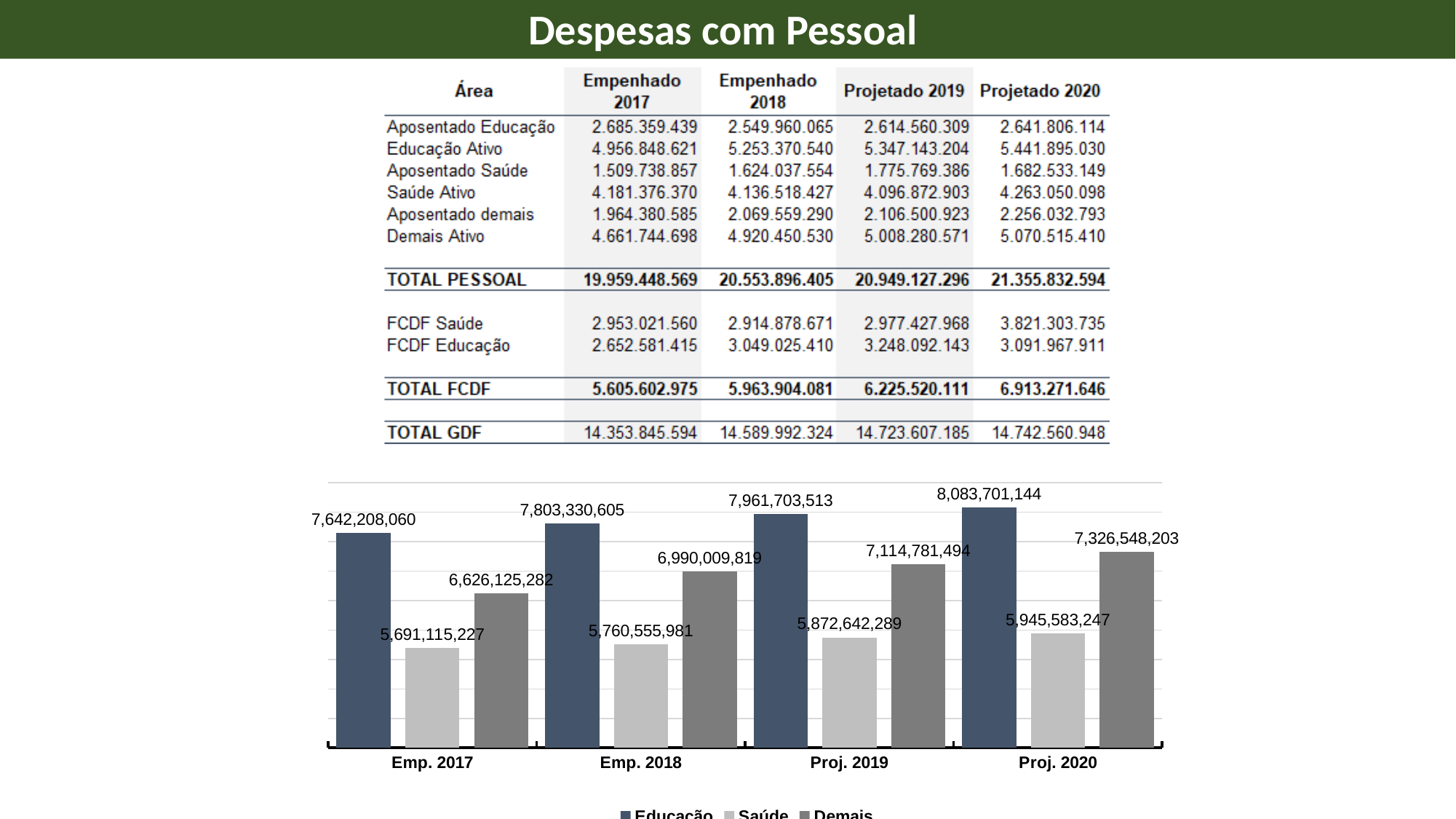
In the bar chart, which is larger: Demais in Emp. 2018 or Saúde in Proj. 2020? Demais in Emp. 2018 In the bar chart, what is the value for Saúde in Proj. 2019? 5,872,642,289 In the bar chart, what is the value for Demais in Emp. 2018? 6,990,009,819 In the bar chart, what is the difference between the Educação value in Proj. 2020 and in Emp. 2017? 441,493,084 In the bar chart, what is the difference between the Demais value in Emp. 2018 and in Emp. 2017? 363,884,537 In the bar chart, in which period is the Saúde value lowest? Emp. 2017 In the bar chart, what is the value for Educação in Proj. 2020? 8,083,701,144 What type of chart is shown at the bottom of the slide? bar chart In the bar chart, what is the value for Educação in Emp. 2017? 7,642,208,060 How many series does the legend of the bar chart list? 3 In the bar chart, in which period is the Educação value highest? Proj. 2020 How many periods are shown on the x axis of the bar chart? 4